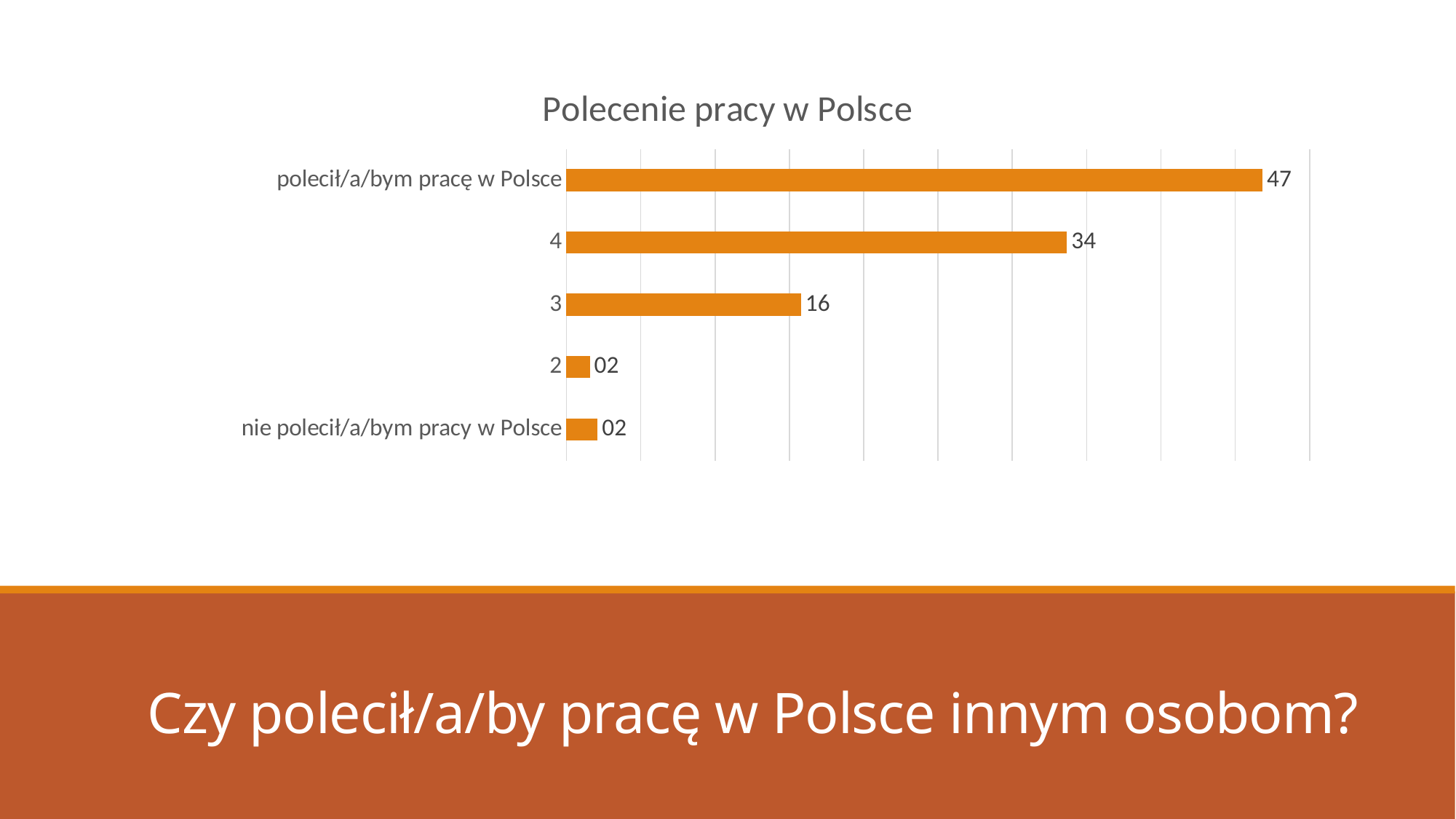
Which category has the highest value? polecił/a/bym pracę w Polsce What is the title of the chart? Polecenie pracy w Polsce Which is larger, the value for category "3" or the value for category "2"? 3 What is the value for category "2"? 02 What is the value for category "3"? 16 What is the difference between the values for "polecił/a/bym pracę w Polsce" and category "4"? 13 What is the value for category "4"? 34 How many categories are shown in the chart? 5 What kind of chart is shown on the slide? bar chart What is the value for "polecił/a/bym pracę w Polsce"? 47 What is the difference between the values for category "4" and category "3"? 18 What is the value for "nie polecił/a/bym pracy w Polsce"? 02